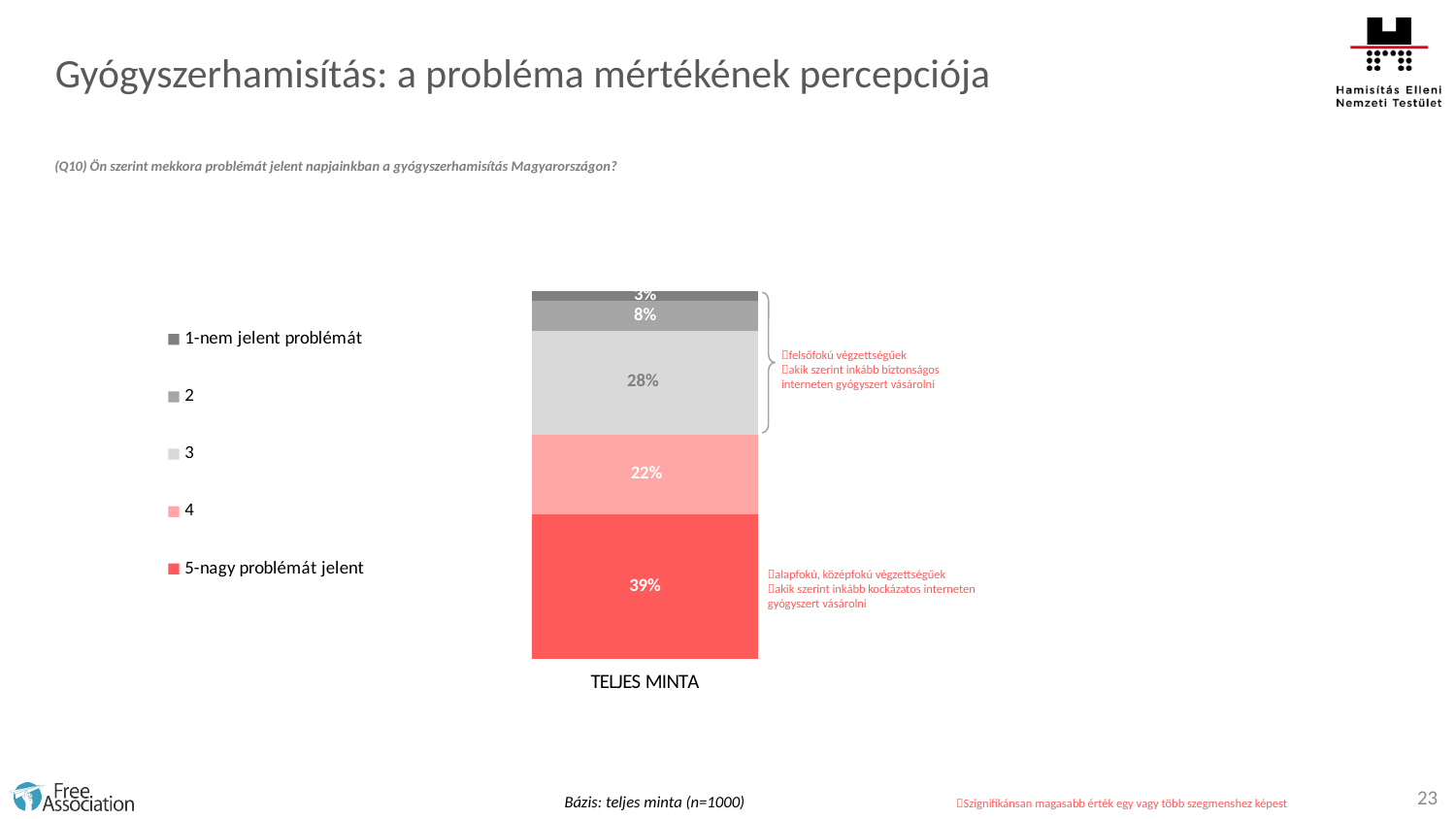
What percentage of the TELJES MINTA bar is for '5-nagy problémát jelent'? 39% What percentage of the TELJES MINTA bar is for '1-nem jelent problémát'? 3% What percentage of the TELJES MINTA bar is for '2'? 8% Which response category has the largest share in the TELJES MINTA bar? 5-nagy problémát jelent What percentage of the TELJES MINTA bar is for '3'? 28% What is the total of all segments in the TELJES MINTA stacked bar? 100% What kind of chart is shown on the slide? Stacked bar chart What is the difference between the share for '5-nagy problémát jelent' and the share for '4'? 17 percentage points What percentage of the TELJES MINTA bar is for '4'? 22% How many series does the legend list? 5 Which response category has the smallest share in the TELJES MINTA bar? 1-nem jelent problémát Which is larger in the TELJES MINTA bar: the share for '3' or the share for '4'? 3